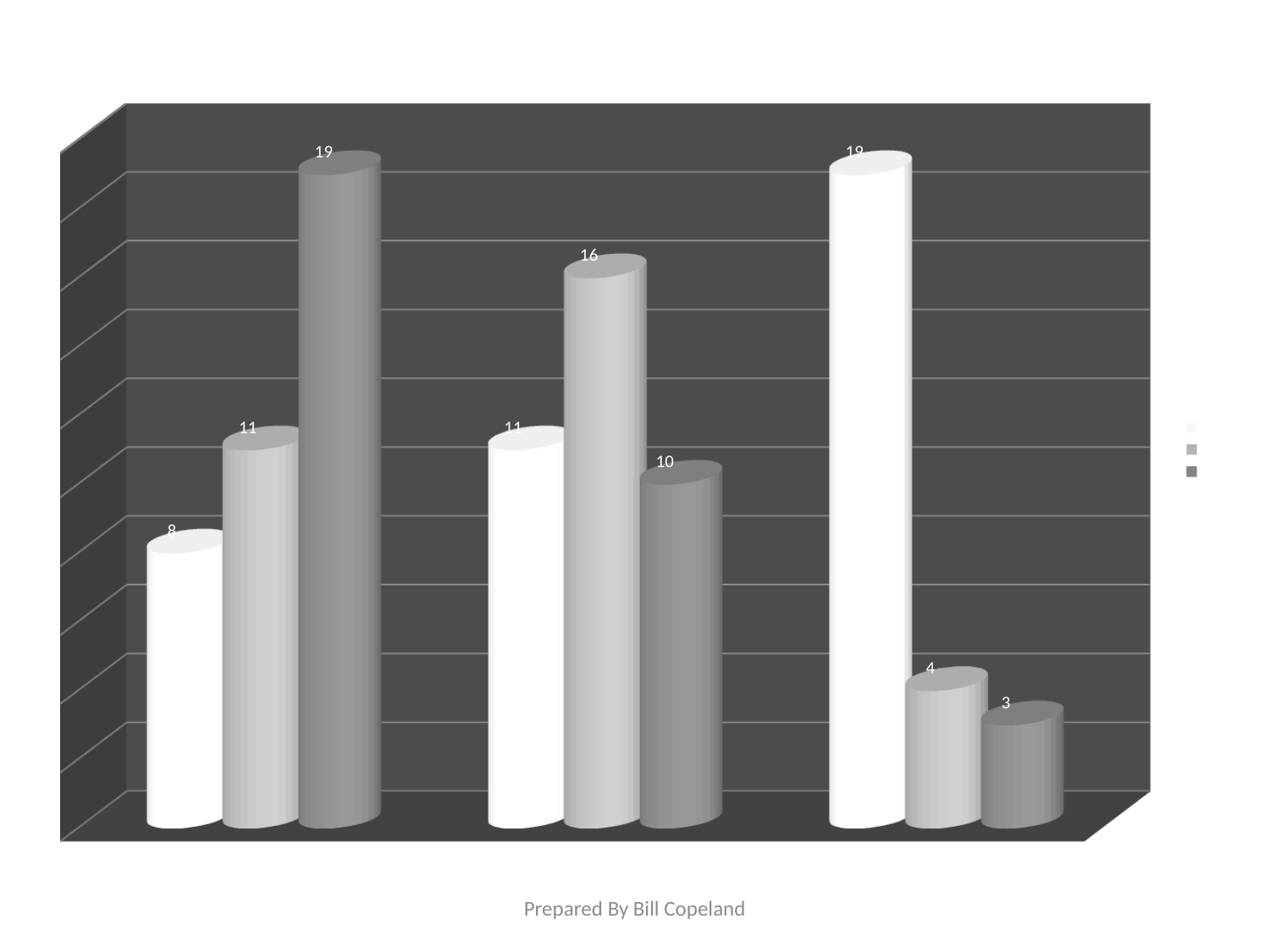
What is the value of the white bar in the third (rightmost) group? 19 In the first (leftmost) group, what is the difference between the dark grey bar and the white bar? 11 What is the lowest value labelled on the chart? 3 What is the highest value labelled on the chart? 19 What kind of chart is shown on the slide? bar chart In the second (middle) group, which is larger: the light grey bar or the dark grey bar? the light grey bar What is the value of the dark grey bar in the third (rightmost) group? 3 Do the values of the dark grey series rise or fall from the first group to the third group? fall What is the value of the light grey bar in the second (middle) group? 16 How many series does the legend list? 3 How many groups of bars are plotted along the x axis? 3 What is the value of the white bar in the first (leftmost) group? 8